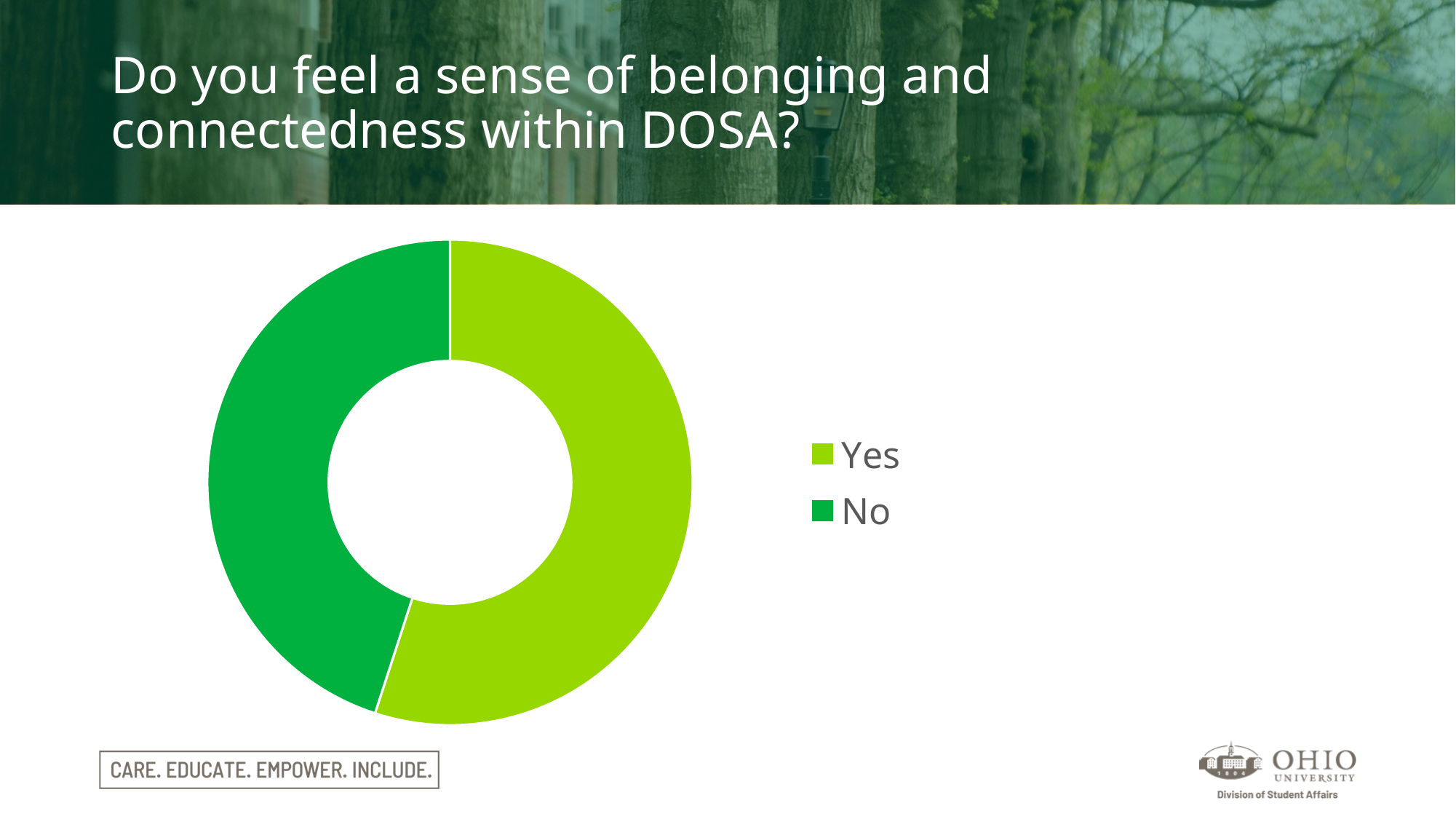
Does the Yes slice take up more or less than half of the pie chart? More Which legend entry is shown in the lighter green colour? Yes Which slice is larger, Yes or No? Yes Which category has the largest slice of the pie chart? Yes How many entries does the legend list? 2 How many categories does the pie chart show? 2 What kind of chart is shown on the slide? Pie chart (donut) What question does the slide title ask? Do you feel a sense of belonging and connectedness within DOSA? Which category has the smallest slice of the pie chart? No